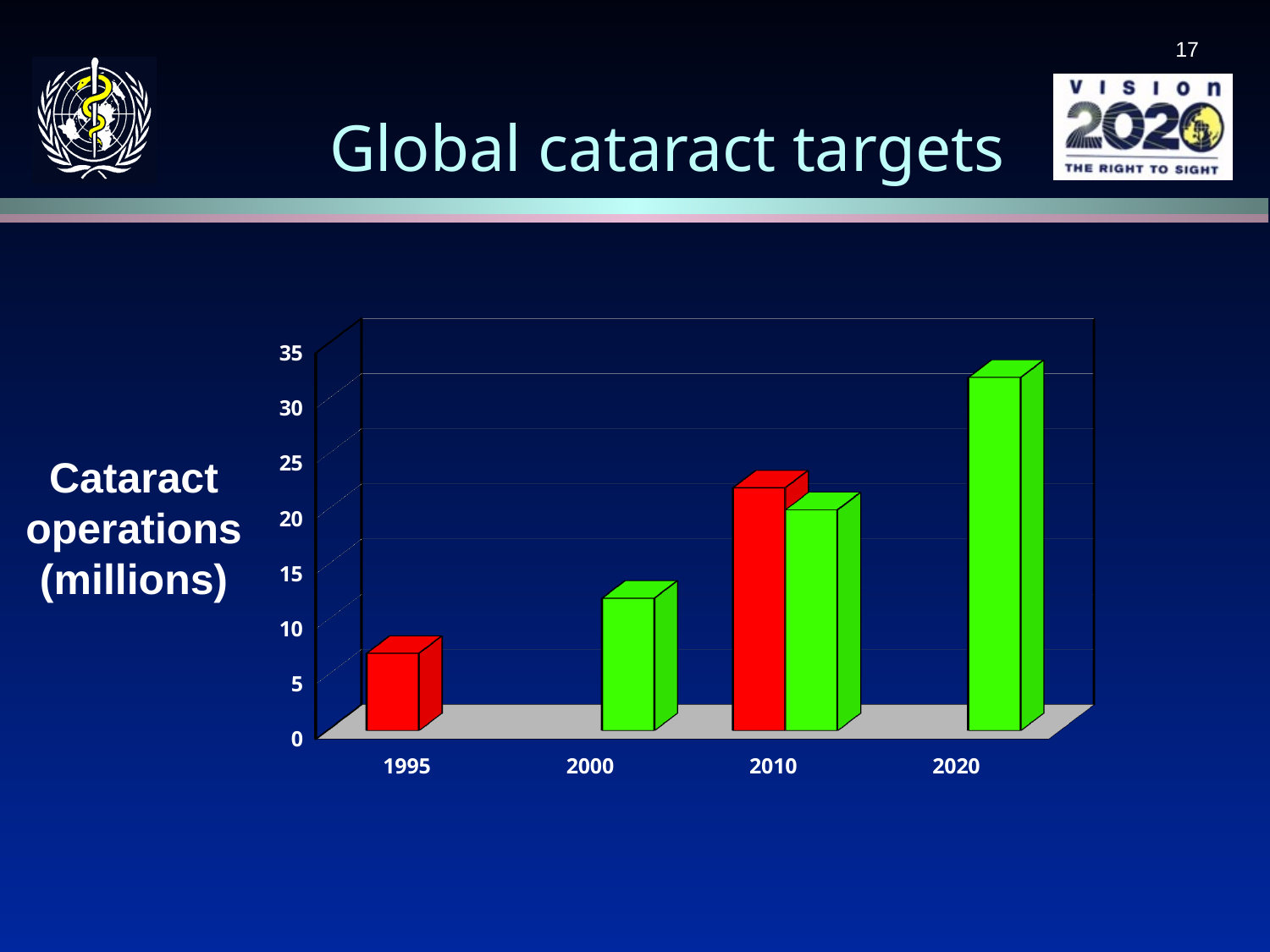
Is the value for 2020 greater or less than 30? greater Which is larger, the bar for 2000 or the bar for 1995? 2000 Which year has the shortest bar in the chart? 1995 Is the value for 2000 greater or less than 10? greater Do the bar heights generally rise or fall from 1995 to 2020? rise How many years are shown along the x axis of the chart? 4 What kind of chart is shown on the slide? bar chart Is the value for 1995 greater or less than 10? less What quantity does the vertical axis of the chart represent, according to the label beside it? Cataract operations (millions) What is the title of the chart on the slide? Global cataract targets Which year has the tallest bar in the chart? 2020